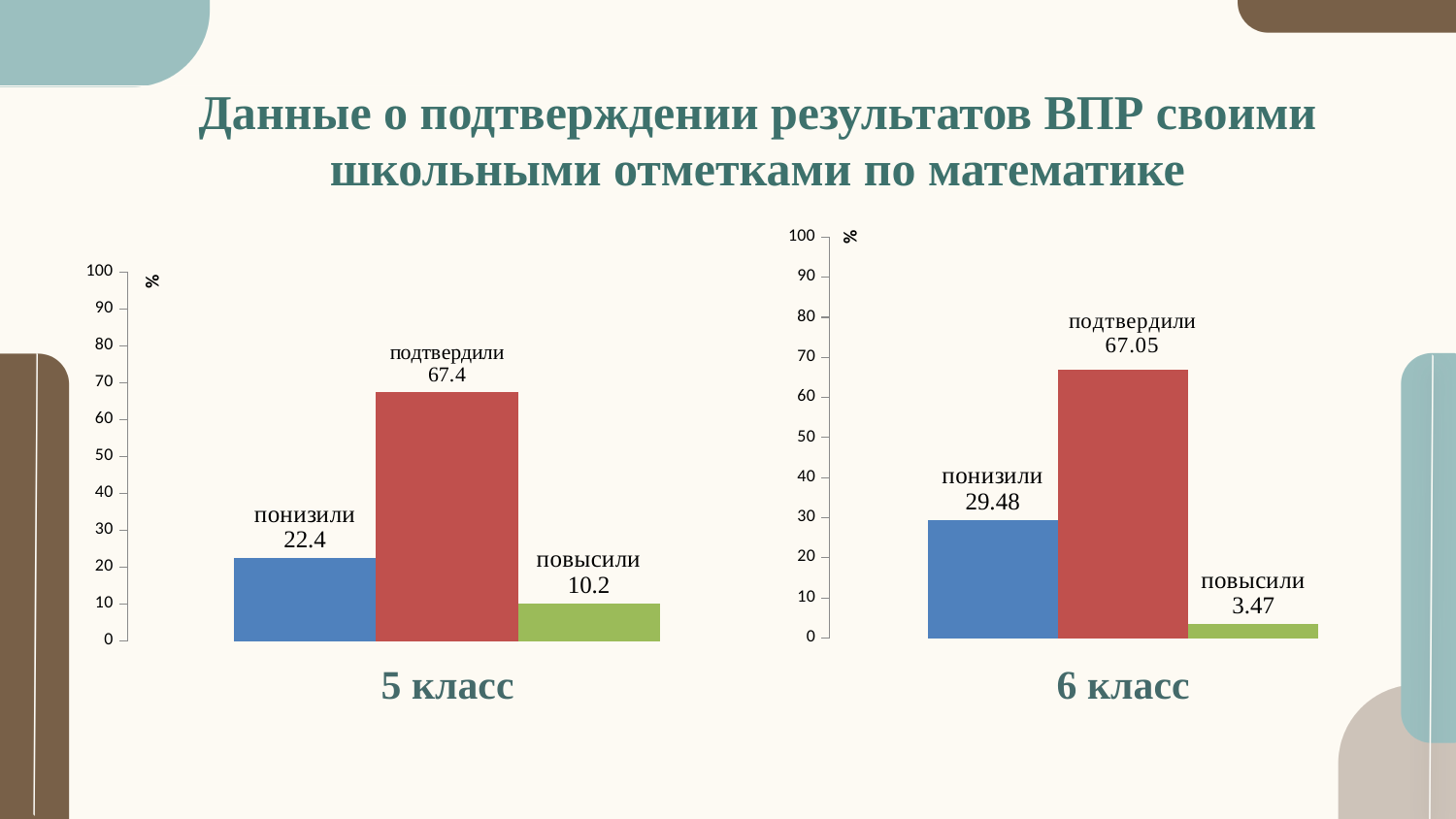
In the 6 класс chart, what is the value for понизили? 29.48 What unit is shown on the vertical axis of the 6 класс chart? % How many categories are shown in the 6 класс chart? 3 In the 6 класс chart, which category has the lowest value? повысили In the 6 класс chart, what is the value for повысили? 3.47 What type of chart is the 5 класс chart? bar chart In the 6 класс chart, what is the difference between понизили and повысили? 26.01 Which is larger: понизили in the 5 класс chart or понизили in the 6 класс chart? 6 класс In the 5 класс chart, is the value for повысили greater or less than 20? less In the 5 класс chart, what is the difference between подтвердили and понизили? 45 In the 5 класс chart, what is the value for подтвердили? 67.4 In the 5 класс chart, which category has the highest value? подтвердили